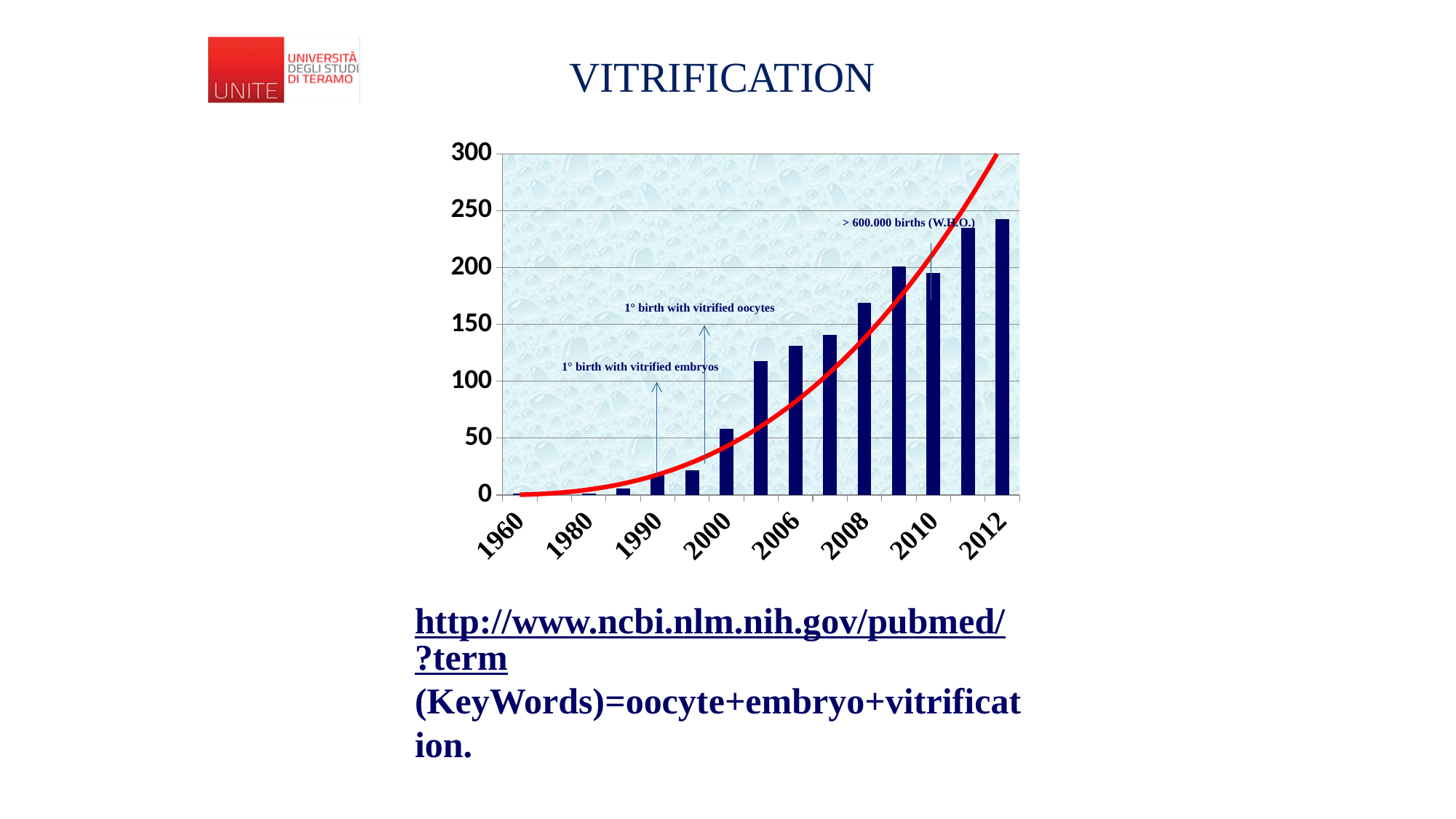
Do the bar values generally rise or fall from 1960 to 2012? rise Is the value for 2000 greater or less than 100? less What does the annotation near the top right of the chart say? > 600.000 births (W.H.O.) Is the value for 2000 greater or less than 50? greater Which is larger, the value for 2006 or the value for 2000? 2006 Which labelled year has the highest bar? 2012 How many year labels are shown on the x axis? 8 Which is larger, the value for 2012 or the value for 2010? 2012 Is the value for 1990 greater or less than 50? less What kind of chart is shown on the slide? bar chart